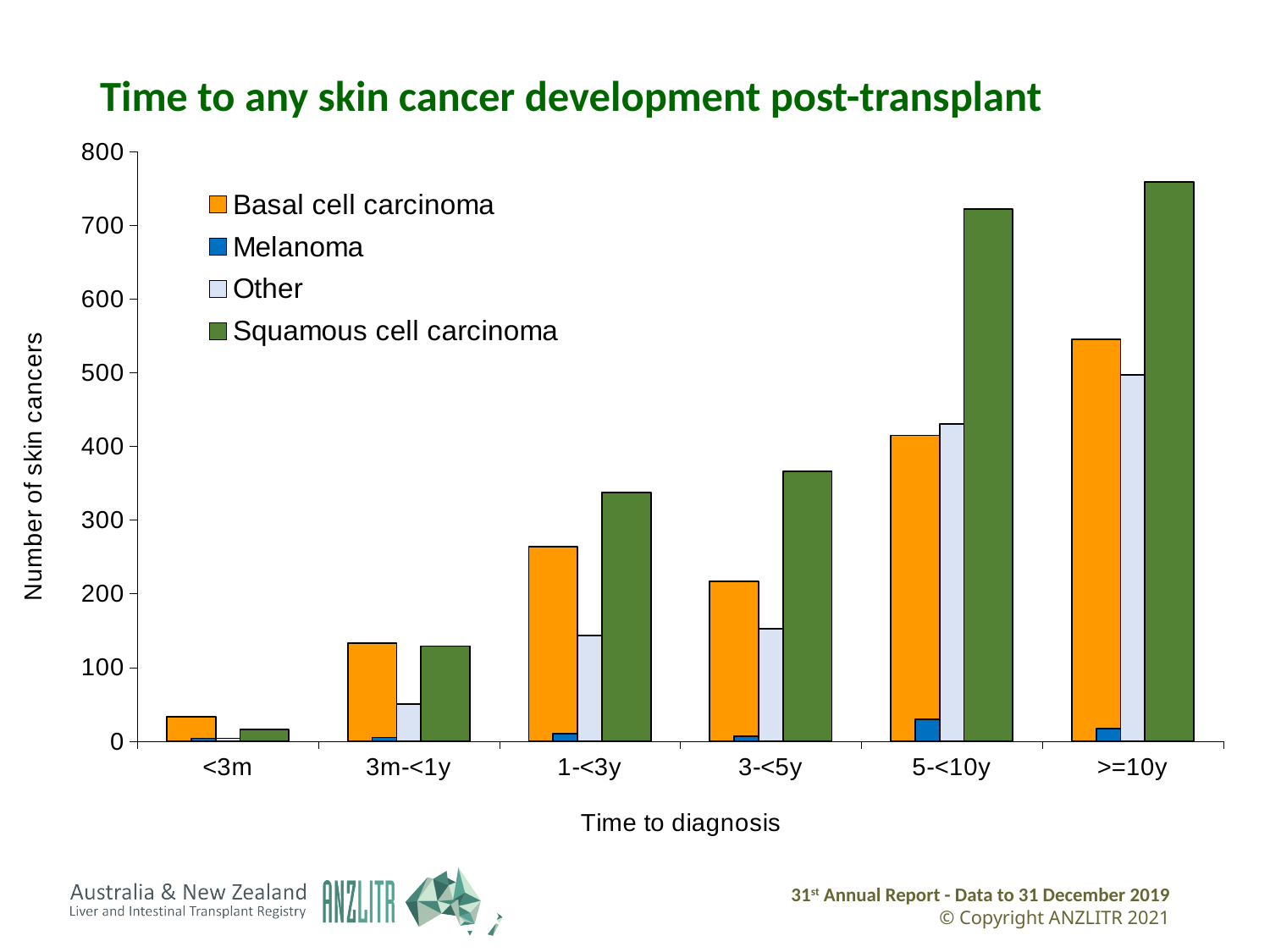
How many series does the legend list? 4 Which time-to-diagnosis category has the highest Squamous cell carcinoma bar? >=10y Is the Squamous cell carcinoma value for 5-<10y greater or less than 700? greater Is the Other value for 3m-<1y greater or less than 100? less Is the Basal cell carcinoma value for >=10y greater or less than 500? greater Do the Squamous cell carcinoma values rise or fall from <3m to >=10y? rise In the 1-<3y category, which is larger: Squamous cell carcinoma or Basal cell carcinoma? Squamous cell carcinoma What kind of chart is shown on the slide? bar chart Which time-to-diagnosis category has the highest Basal cell carcinoma bar? >=10y How many time-to-diagnosis categories are shown on the x axis? 6 Which series has the lowest bar in the >=10y category? Melanoma